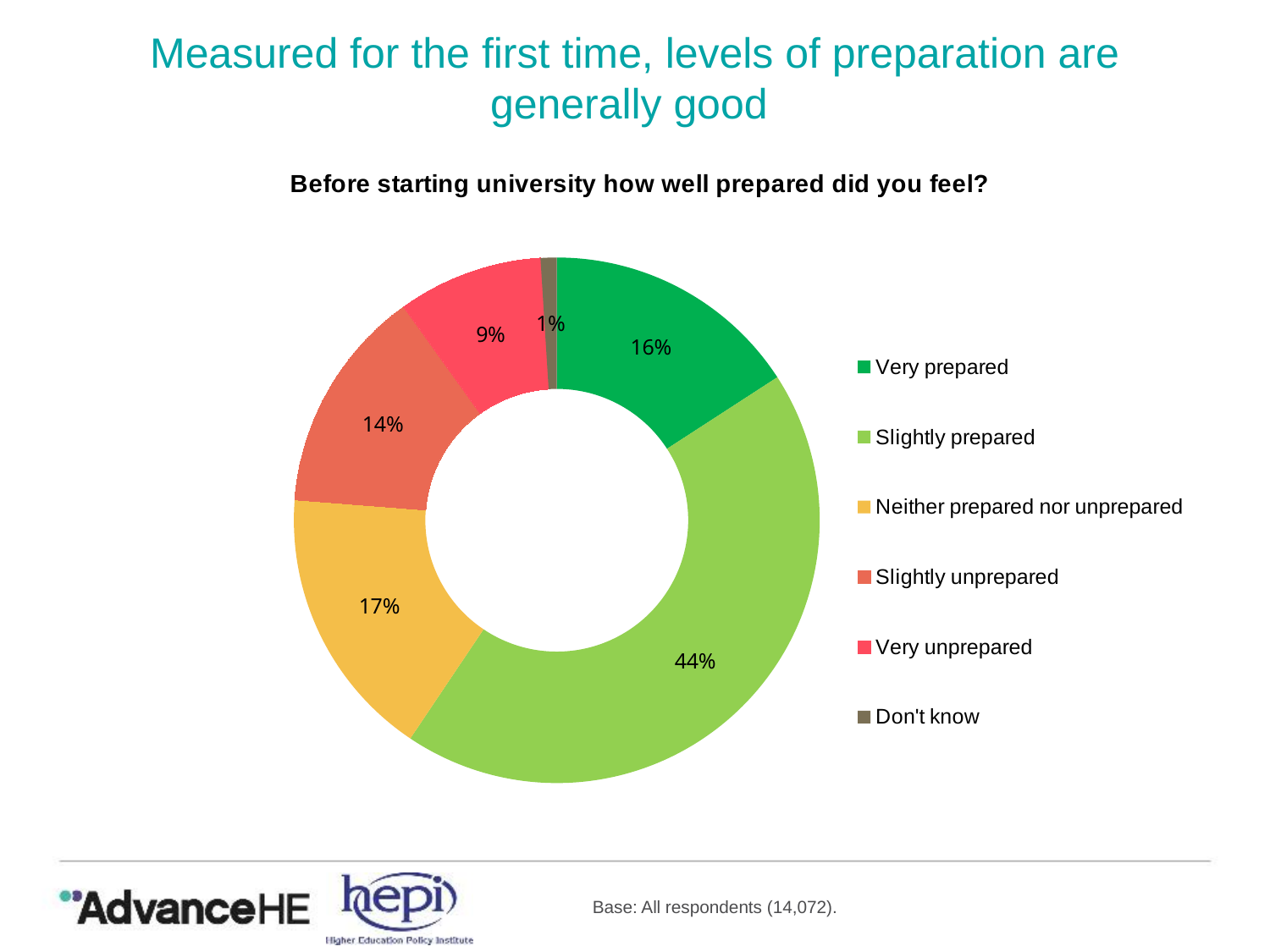
What percentage of respondents said they were slightly prepared? 44% What percentage of respondents answered 'Neither prepared nor unprepared'? 17% What percentage of respondents said they were very unprepared? 9% Which response category has the largest share of the chart? Slightly prepared Which is larger: the share for 'Slightly unprepared' or the share for 'Very unprepared'? Slightly unprepared What is the combined percentage of respondents who felt very prepared or slightly prepared? 60% Which response category has the smallest share of the chart? Don't know What is the title of the chart? Before starting university how well prepared did you feel? What is the difference in percentage points between 'Slightly prepared' and 'Very prepared'? 28 How many response categories does the legend list? 6 What percentage of respondents said they were very prepared? 16% What kind of chart is shown on the slide? Doughnut (pie) chart